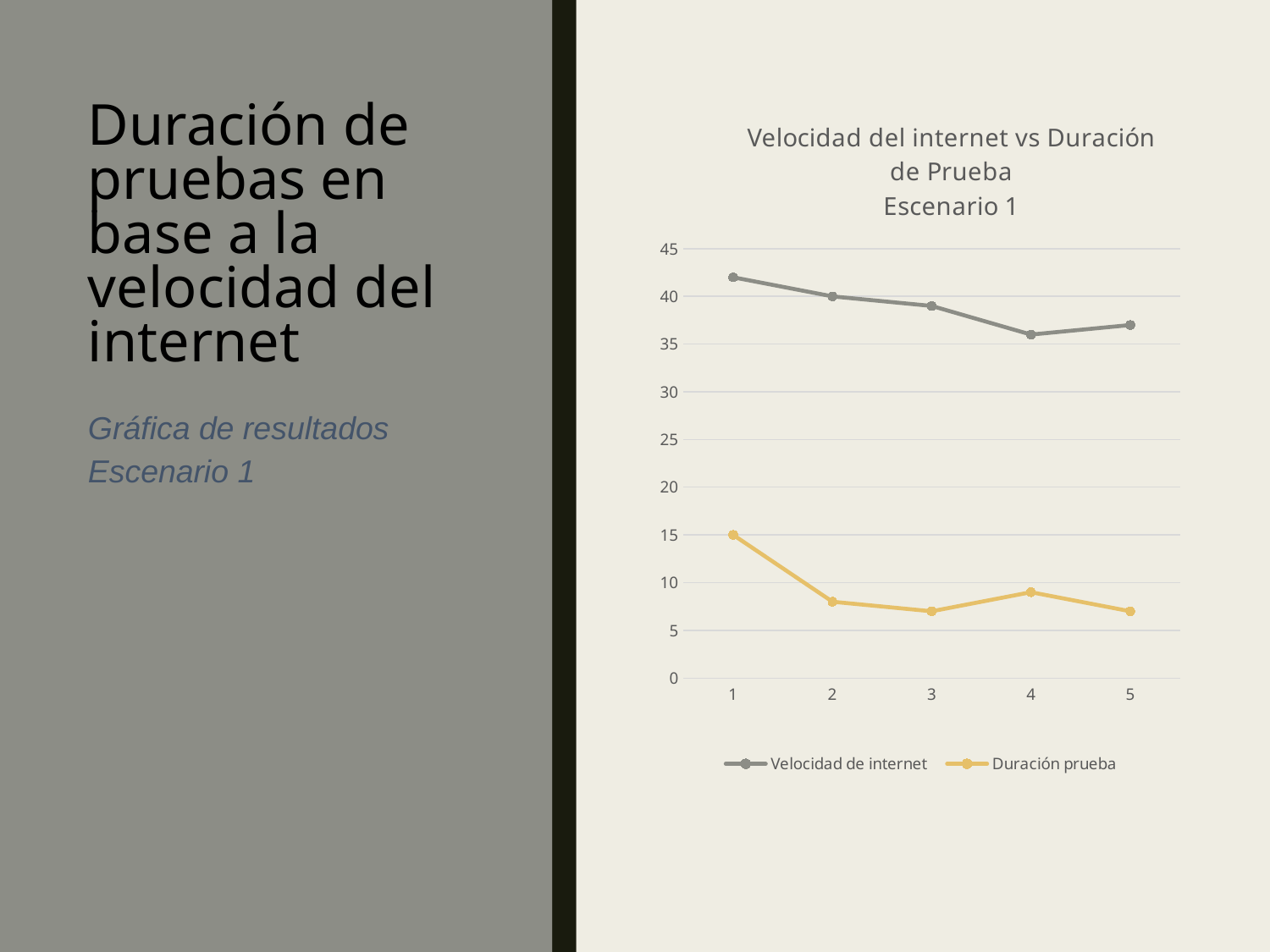
Is the value for Duración prueba at x = 3 greater or less than 10? less How many points are plotted along the x axis for each series? 5 How many series does the legend list? 2 Does Velocidad de internet generally rise or fall from x = 1 to x = 5? Fall Is the value for Velocidad de internet at x = 4 greater or less than 40? less At which x value is Velocidad de internet highest? 1 At x = 3, which series has the larger value, Velocidad de internet or Duración prueba? Velocidad de internet What type of chart is shown on the slide? Line chart Is the value for Velocidad de internet at x = 1 greater or less than 40? greater At which x value is Duración prueba highest? 1 What is the value of Duración prueba at x = 1? 15 What is the value of Velocidad de internet at x = 2? 40